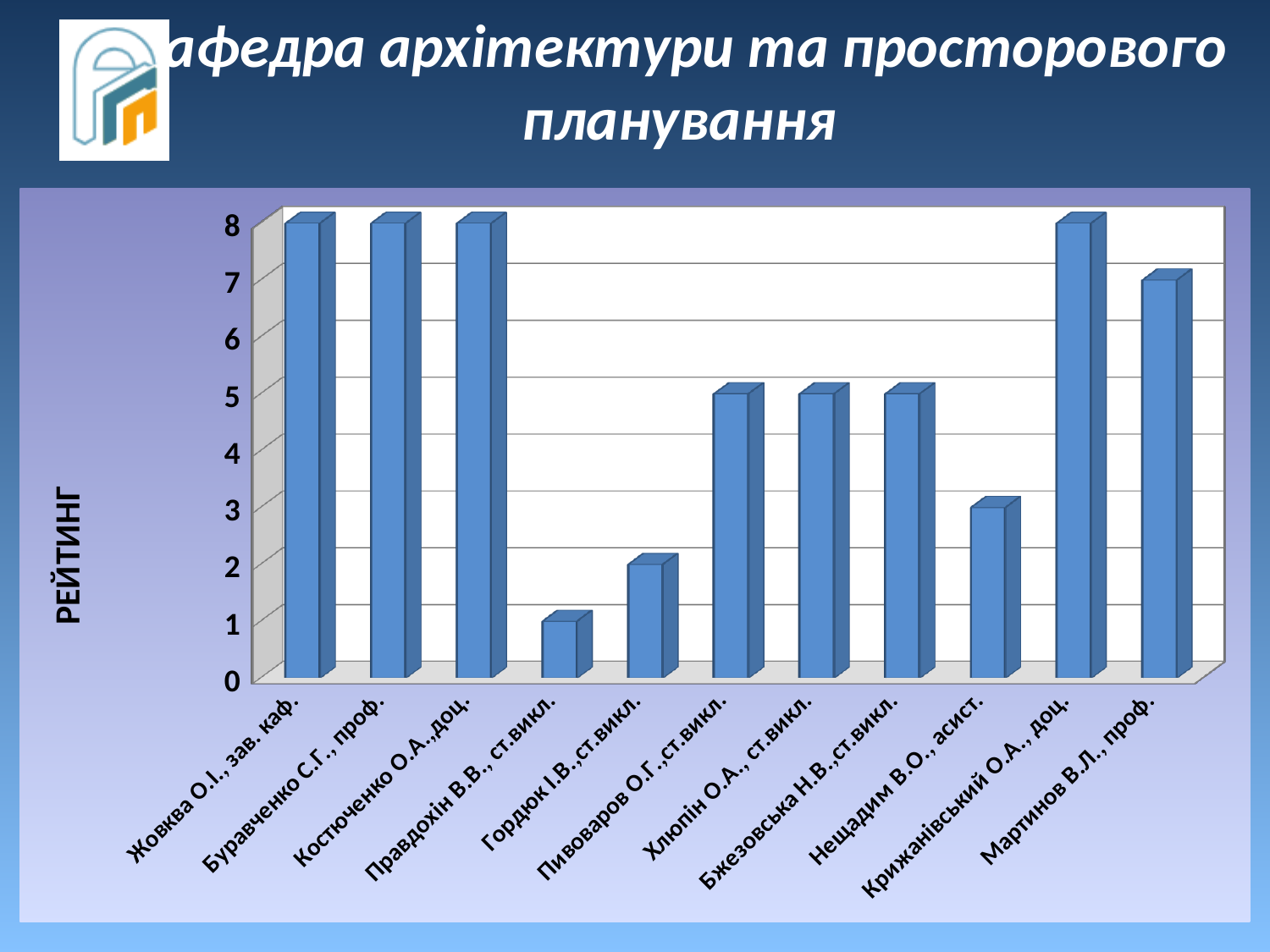
What is the label of the vertical axis of the chart? РЕЙТИНГ What is the rating value for Гордюк І.В., ст.викл.? 2 What kind of chart is shown on the slide? bar chart Is the rating for Гордюк І.В., ст.викл. greater or less than 3? less Is the rating for Пивоваров О.Г., ст.викл. greater or less than 4? greater What is the rating value for Мартинов В.Л., проф.? 7 What is the rating value for Правдохін В.В., ст.викл.? 1 What is the rating value for Нещадим В.О., асист.? 3 Which category has the lowest rating in the chart? Правдохін В.В., ст.викл. How many categories (staff members) are shown on the x axis of the chart? 11 Which is larger, the rating for Хлюпін О.А., ст.викл. or the rating for Нещадим В.О., асист.? Хлюпін О.А., ст.викл. What is the difference between the rating for Мартинов В.Л., проф. and the rating for Нещадим В.О., асист.? 4